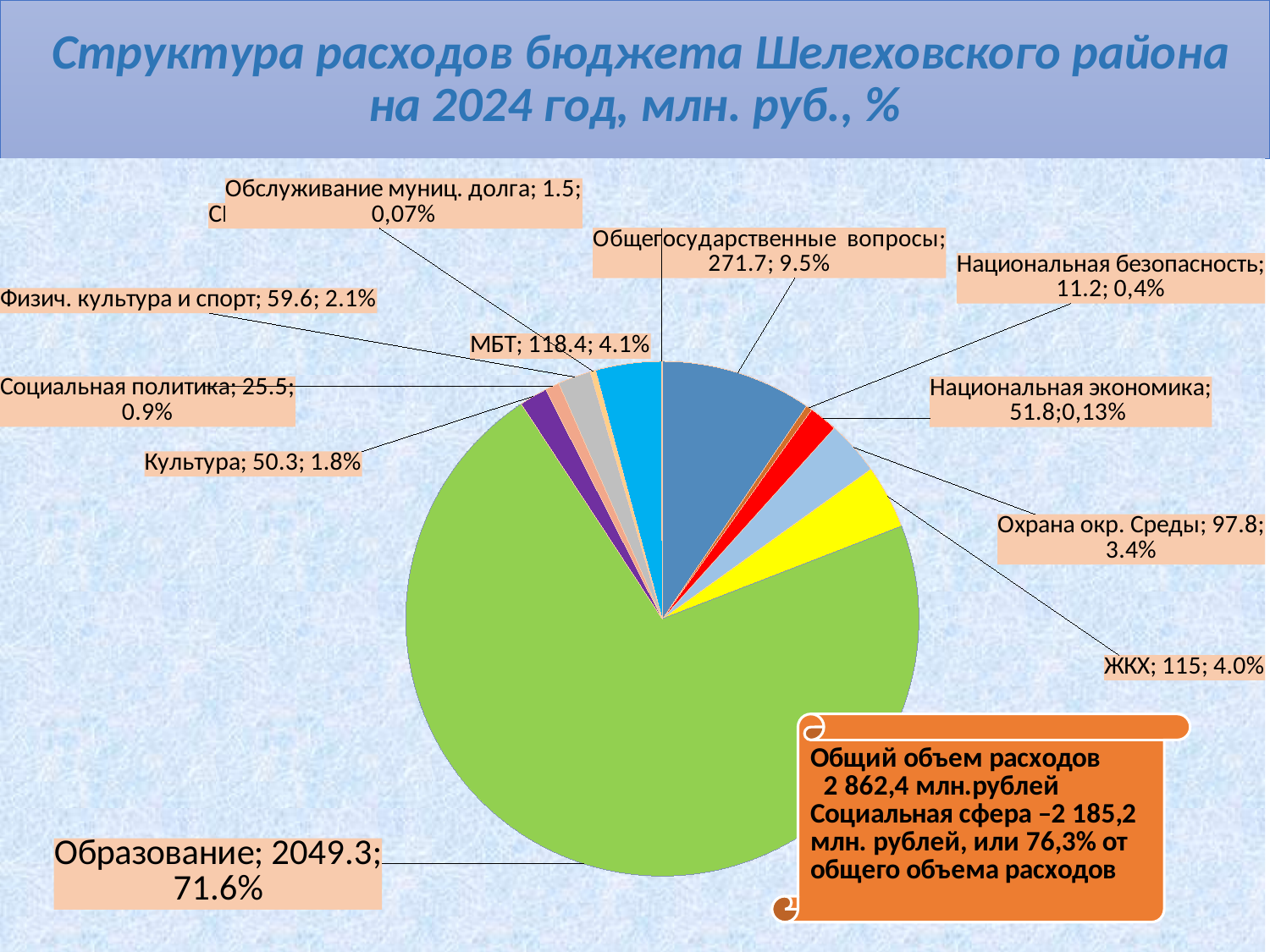
What share of the pie does Образование account for? 71.6% What is the difference between the values for Общегосударственные вопросы and МБТ? 153.3 What value is shown for Национальная безопасность? 11.2 Which category has the largest slice of the pie? Образование What percentage share is shown for Охрана окр. Среды? 3.4% What value is shown for Общегосударственные вопросы? 271.7 What is the difference between the values for Физич. культура и спорт and Культура? 9.3 Which category has the smallest value on the pie chart? Обслуживание муниц. долга Which is larger, the value for МБТ or the value for ЖКХ? МБТ What is the title of the chart on the slide? Структура расходов бюджета Шелеховского района на 2024 год, млн. руб., % What kind of chart is shown on the slide? pie chart What value is shown for Образование on the pie chart? 2049.3